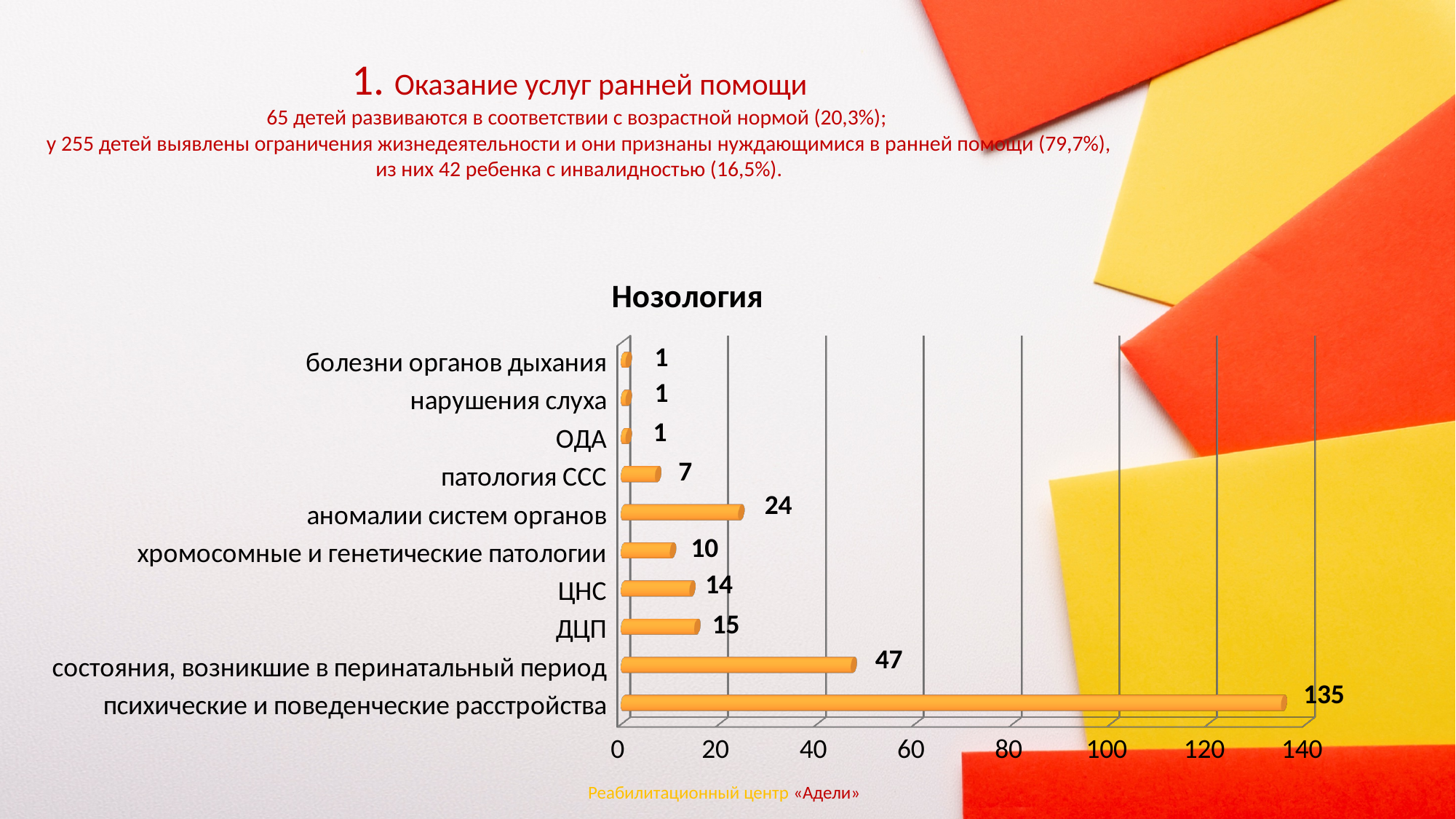
What is the difference between the values for ДЦП and ЦНС? 1 What is the value for патология ССС? 7 What is the value for психические и поведенческие расстройства? 135 What is the value for аномалии систем органов? 24 What is the value for состояния, возникшие в перинатальный период? 47 What is the difference between the values for психические и поведенческие расстройства and состояния, возникшие в перинатальный период? 88 What kind of chart is shown on the slide? bar chart Is the value for психические и поведенческие расстройства greater or less than 120? greater What is the title of the chart? Нозология How many categories are shown in the chart? 10 Which category has the highest value? психические и поведенческие расстройства Which is larger, the value for аномалии систем органов or the value for хромосомные и генетические патологии? аномалии систем органов